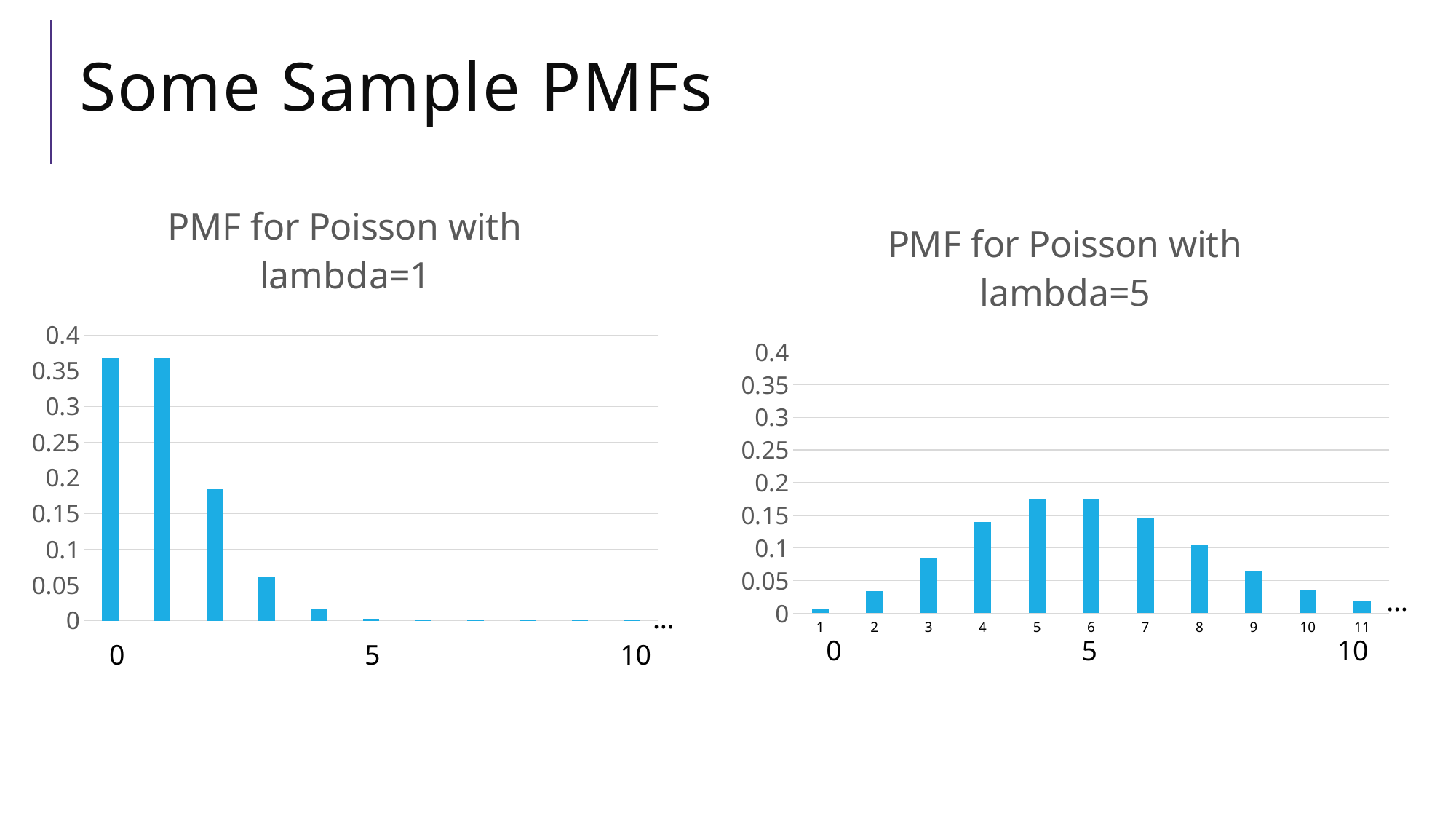
In the 'PMF for Poisson with lambda=5' chart, is the value of the bar labelled 11 greater or less than 0.05? less What is the title of the chart on the right of the slide? PMF for Poisson with lambda=5 In the 'PMF for Poisson with lambda=1' chart, which is larger, the value at x = 2 or the value at x = 3? x = 2 In the 'PMF for Poisson with lambda=1' chart, do the values rise or fall as x increases? fall In the 'PMF for Poisson with lambda=5' chart, which is larger, the bar labelled 4 or the bar labelled 9? the bar labelled 4 In the 'PMF for Poisson with lambda=1' chart, is the value at x = 4 greater or less than 0.05? less In the 'PMF for Poisson with lambda=1' chart, is the value at x = 0 greater or less than 0.3? greater How many bars are plotted in the 'PMF for Poisson with lambda=5' chart? 11 What kind of chart is the 'PMF for Poisson with lambda=1' chart? bar chart In the 'PMF for Poisson with lambda=5' chart, which bar is the lowest? the bar labelled 1